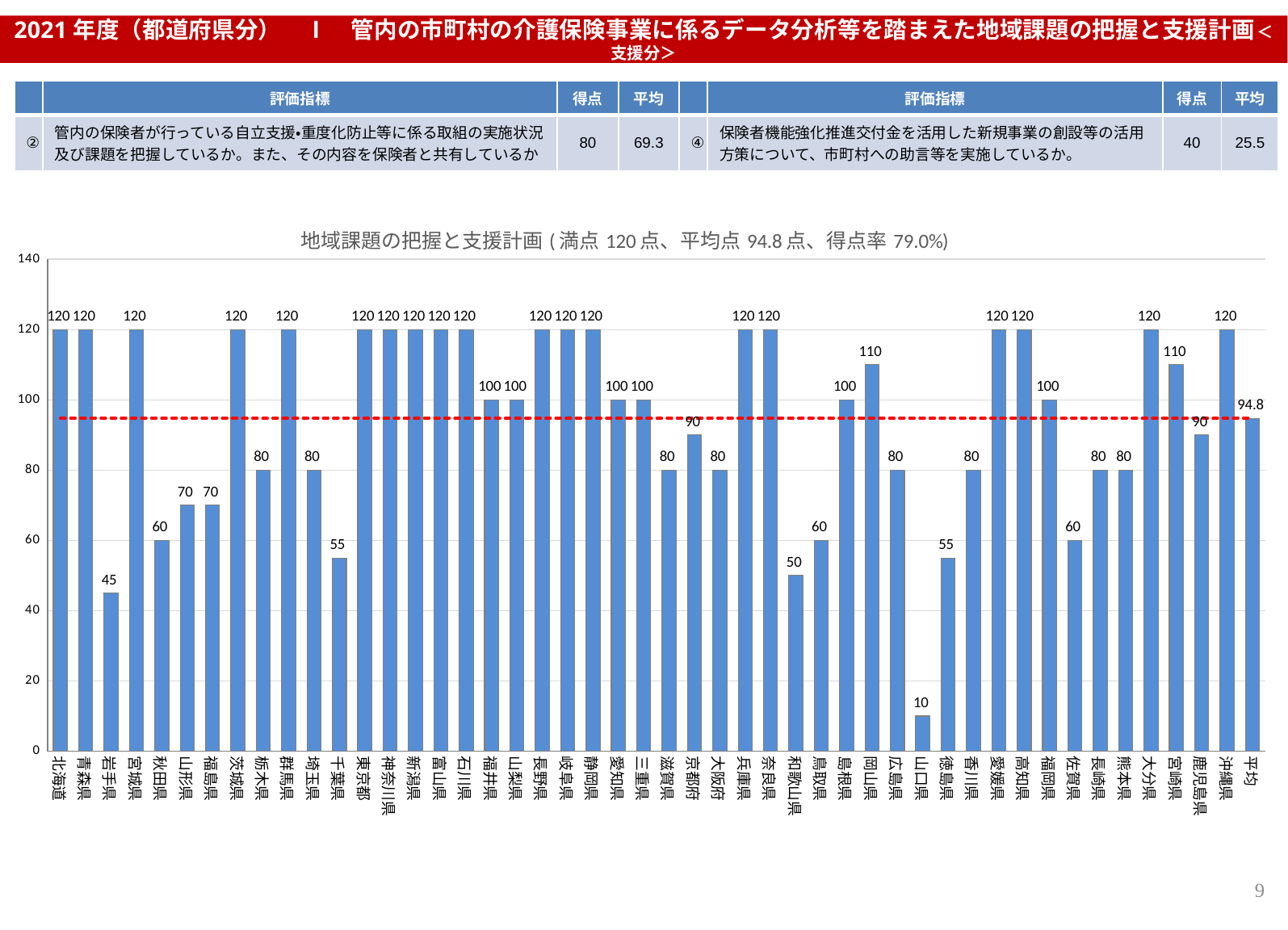
What is the value for 山口県? 10 How many bars are plotted in the chart? 48 What is the title of the chart? 地域課題の把握と支援計画 (満点 120点、平均点 94.8点、得点率 79.0%) What is the difference between the values for 岡山県 and 広島県? 30 What is the difference between the values for 北海道 and 岩手県? 75 What is the value for 千葉県? 55 Is the value for 京都府 greater or less than 80? greater What kind of chart is shown on the slide? bar chart What is the value for 岩手県? 45 What is the value shown for 平均? 94.8 Which category has the lowest value? 山口県 Which is larger, the value for 和歌山県 or the value for 鳥取県? 鳥取県